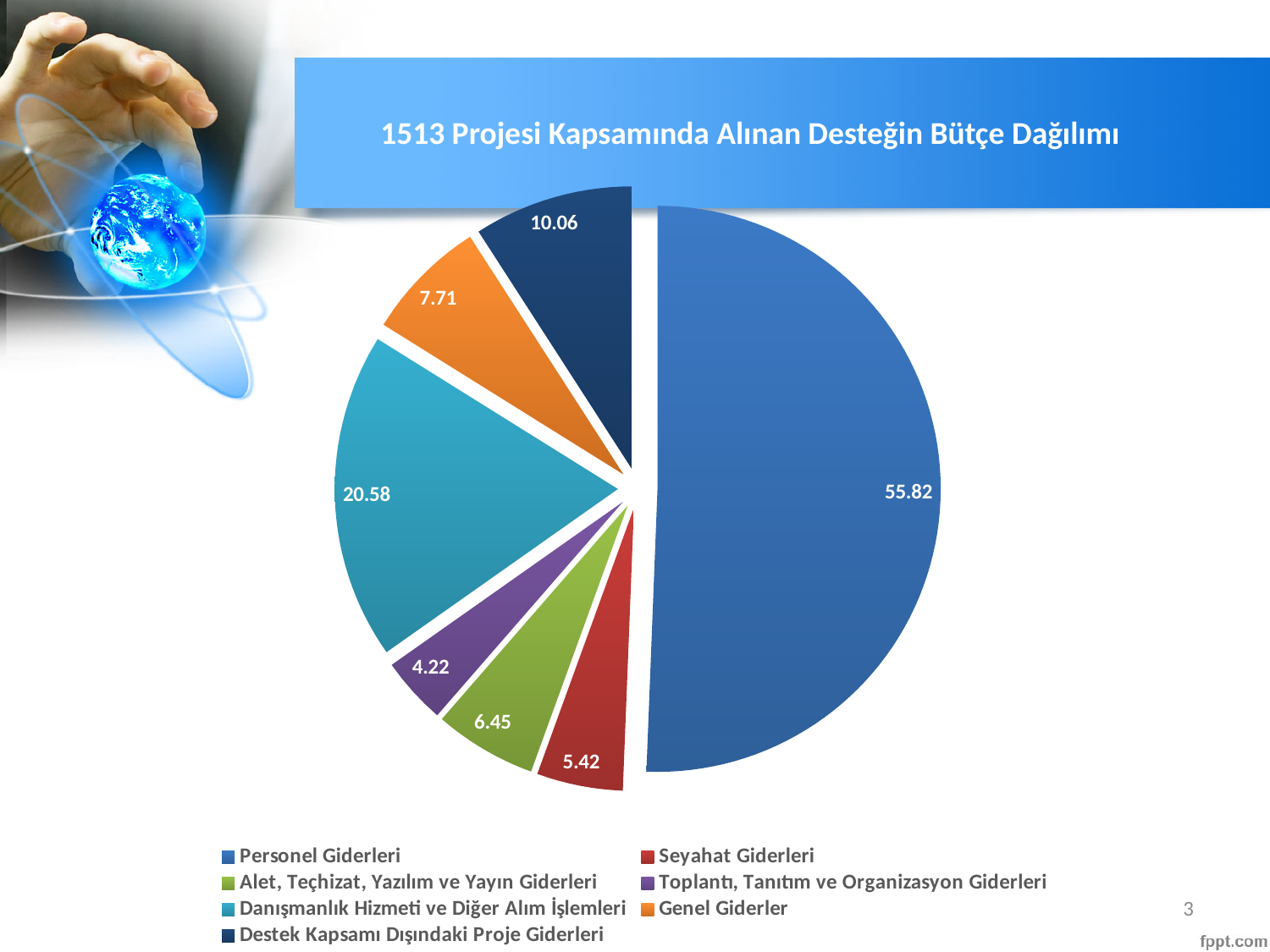
What is the value shown for Toplantı, Tanıtım ve Organizasyon Giderleri? 4.22 Which is larger, the value for Alet, Teçhizat, Yazılım ve Yayın Giderleri or the value for Seyahat Giderleri? Alet, Teçhizat, Yazılım ve Yayın Giderleri What is the value shown for Genel Giderler? 7.71 How many categories does the pie chart show? 7 What kind of chart is shown on the slide? Pie chart What is the title of the chart? 1513 Projesi Kapsamında Alınan Desteğin Bütçe Dağılımı Which category has the smallest slice of the pie? Toplantı, Tanıtım ve Organizasyon Giderleri What is the value shown for Danışmanlık Hizmeti ve Diğer Alım İşlemleri? 20.58 What is the difference between the values for Personel Giderleri and Danışmanlık Hizmeti ve Diğer Alım İşlemleri? 35.24 What is the value shown for Personel Giderleri? 55.82 What is the value shown for Destek Kapsamı Dışındaki Proje Giderleri? 10.06 Which category has the largest slice of the pie? Personel Giderleri